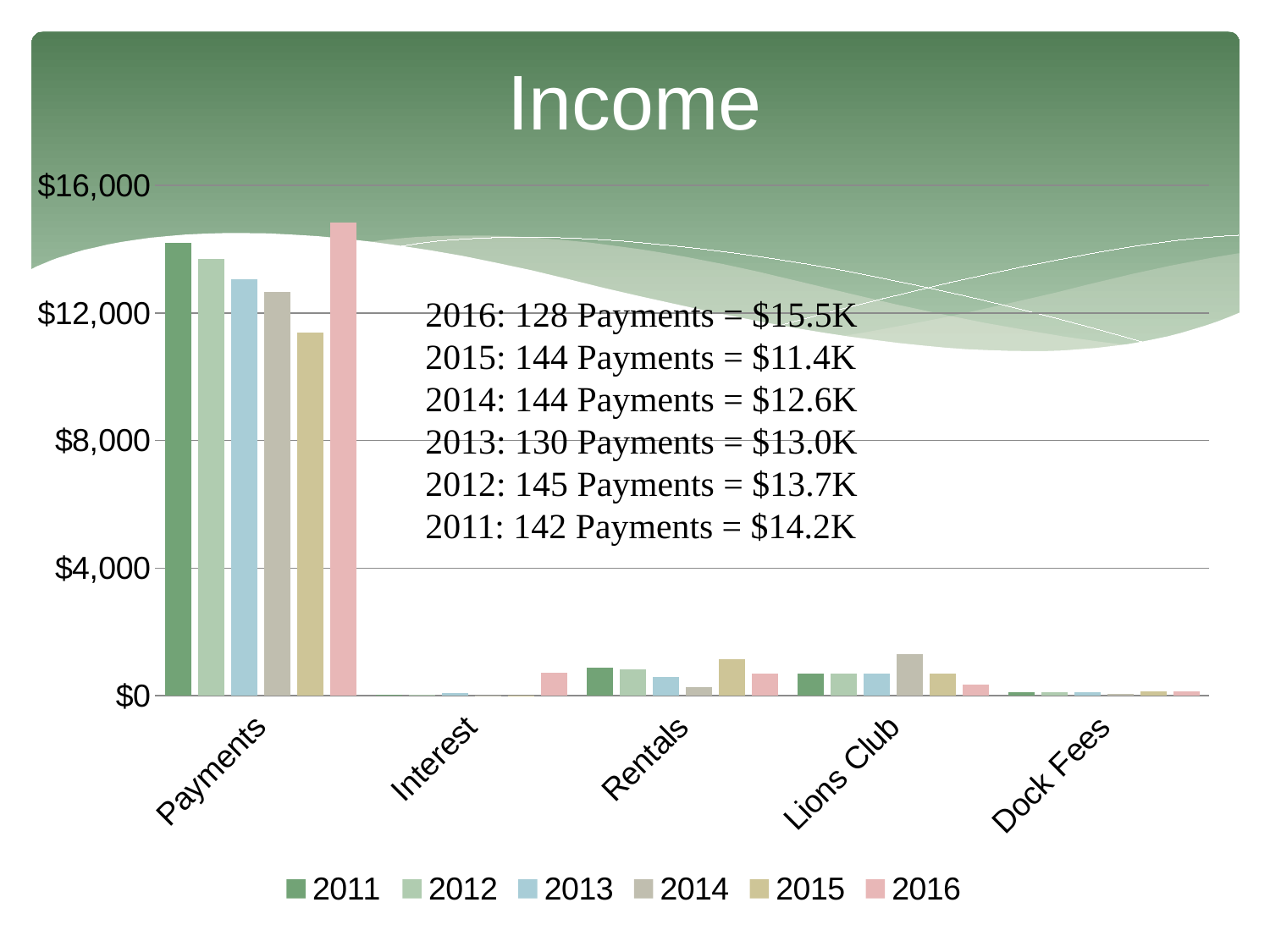
How many categories are shown on the x axis? 5 Which year has the highest bar in the Interest category? 2016 Which year has the lowest bar in the Payments category? 2015 According to the text on the slide, how many payments were received in 2016? 128 What is the title of the chart? Income Which year has the highest bar in the Lions Club category? 2014 Is the value for 2016 Payments greater or less than $12,000? greater Which is larger in the Payments category, the 2011 bar or the 2012 bar? 2011 Which year has the highest bar in the Payments category? 2016 How many series does the legend list? 6 Is the value for 2015 Payments greater or less than $12,000? less What type of chart is shown on the slide? bar chart